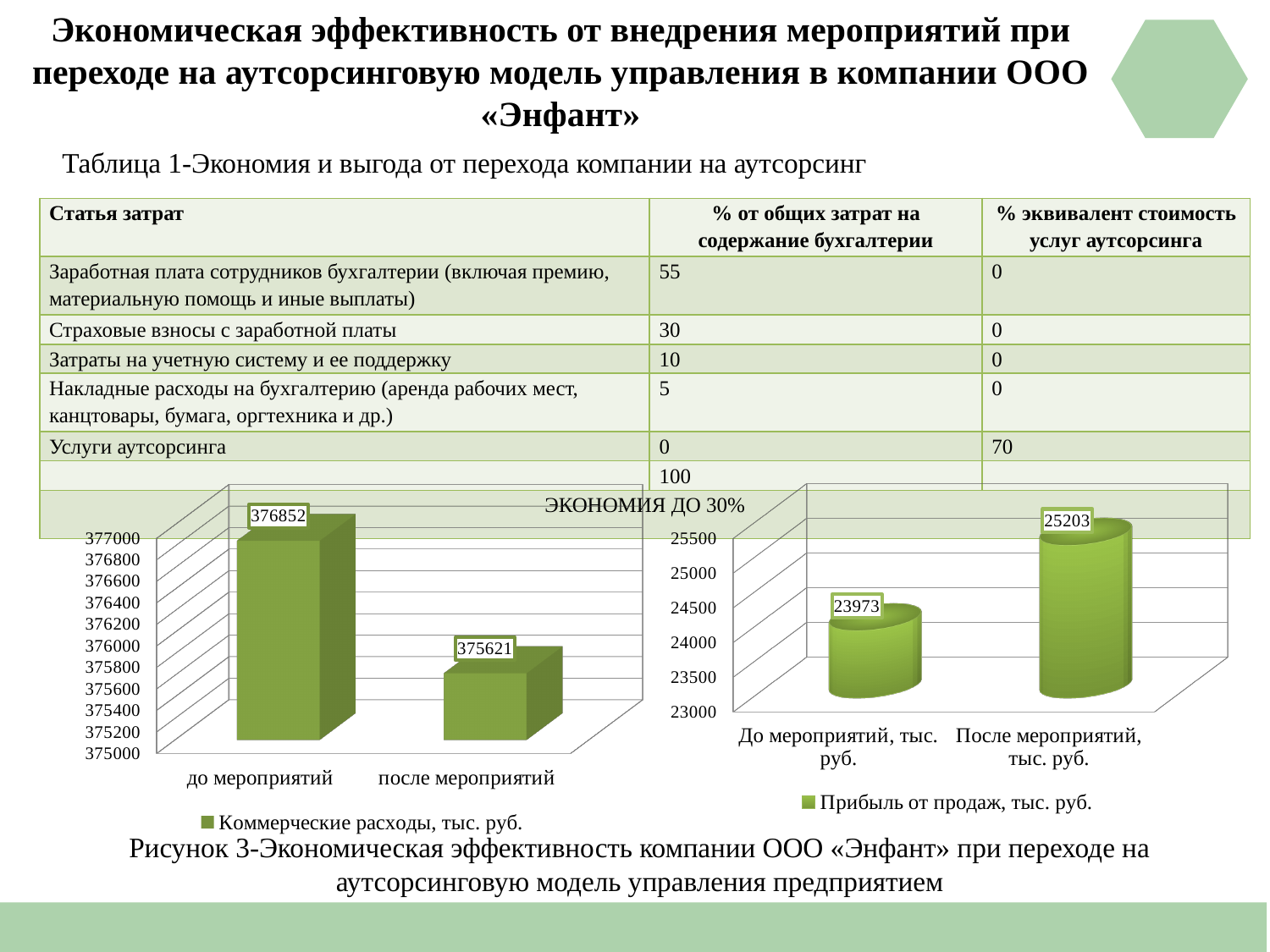
In the left chart (Коммерческие расходы, тыс. руб.), what is the value for «до мероприятий»? 376852 How many categories are shown in the left chart (Коммерческие расходы, тыс. руб.)? 2 In the right chart (Прибыль от продаж, тыс. руб.), by how much does the value after the measures exceed the value before the measures? 1230 In the right chart (Прибыль от продаж, тыс. руб.), is the value for «После мероприятий, тыс. руб.» greater or less than 25000? greater In the right chart (Прибыль от продаж, тыс. руб.), which category has the lower value? До мероприятий, тыс. руб. What kind of chart is the right chart (Прибыль от продаж, тыс. руб.)? bar chart In the left chart (Коммерческие расходы, тыс. руб.), what is the value for «после мероприятий»? 375621 In the right chart (Прибыль от продаж, тыс. руб.), what is the value for «После мероприятий, тыс. руб.»? 25203 In the left chart (Коммерческие расходы, тыс. руб.), which category has the higher value? до мероприятий In the left chart (Коммерческие расходы, тыс. руб.), what is the difference between the values for «до мероприятий» and «после мероприятий»? 1231 What is the legend entry of the left chart? Коммерческие расходы, тыс. руб. In the right chart (Прибыль от продаж, тыс. руб.), what is the value for «До мероприятий, тыс. руб.»? 23973